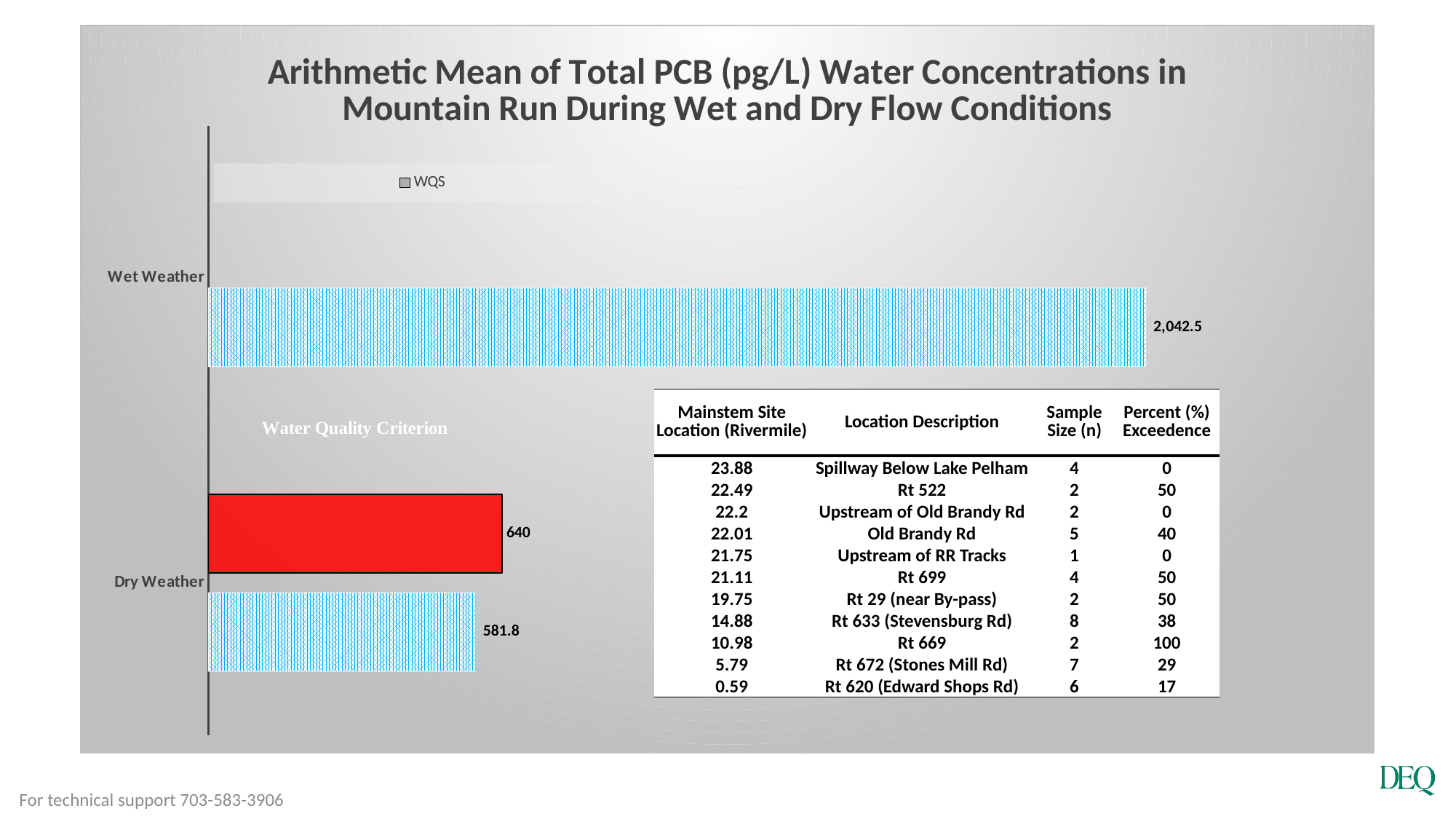
How many weather condition categories are plotted on the chart? 2 Which weather condition has the lower mean total PCB concentration? Dry Weather What is the arithmetic mean total PCB concentration for Wet Weather? 2,042.5 What is the arithmetic mean total PCB concentration for Dry Weather? 581.8 What is the title of the chart? Arithmetic Mean of Total PCB (pg/L) Water Concentrations in Mountain Run During Wet and Dry Flow Conditions What entry is listed in the chart's legend? WQS What value is shown on the red bar representing the Water Quality Criterion? 640 What kind of chart is used to show the PCB concentrations? Bar chart By how much does the Water Quality Criterion (640) exceed the Dry Weather mean concentration? 58.2 What is the difference between the Wet Weather and Dry Weather mean total PCB concentrations? 1,460.7 Which weather condition has the higher mean total PCB concentration? Wet Weather Is the Dry Weather mean total PCB concentration larger or smaller than the Water Quality Criterion of 640? smaller